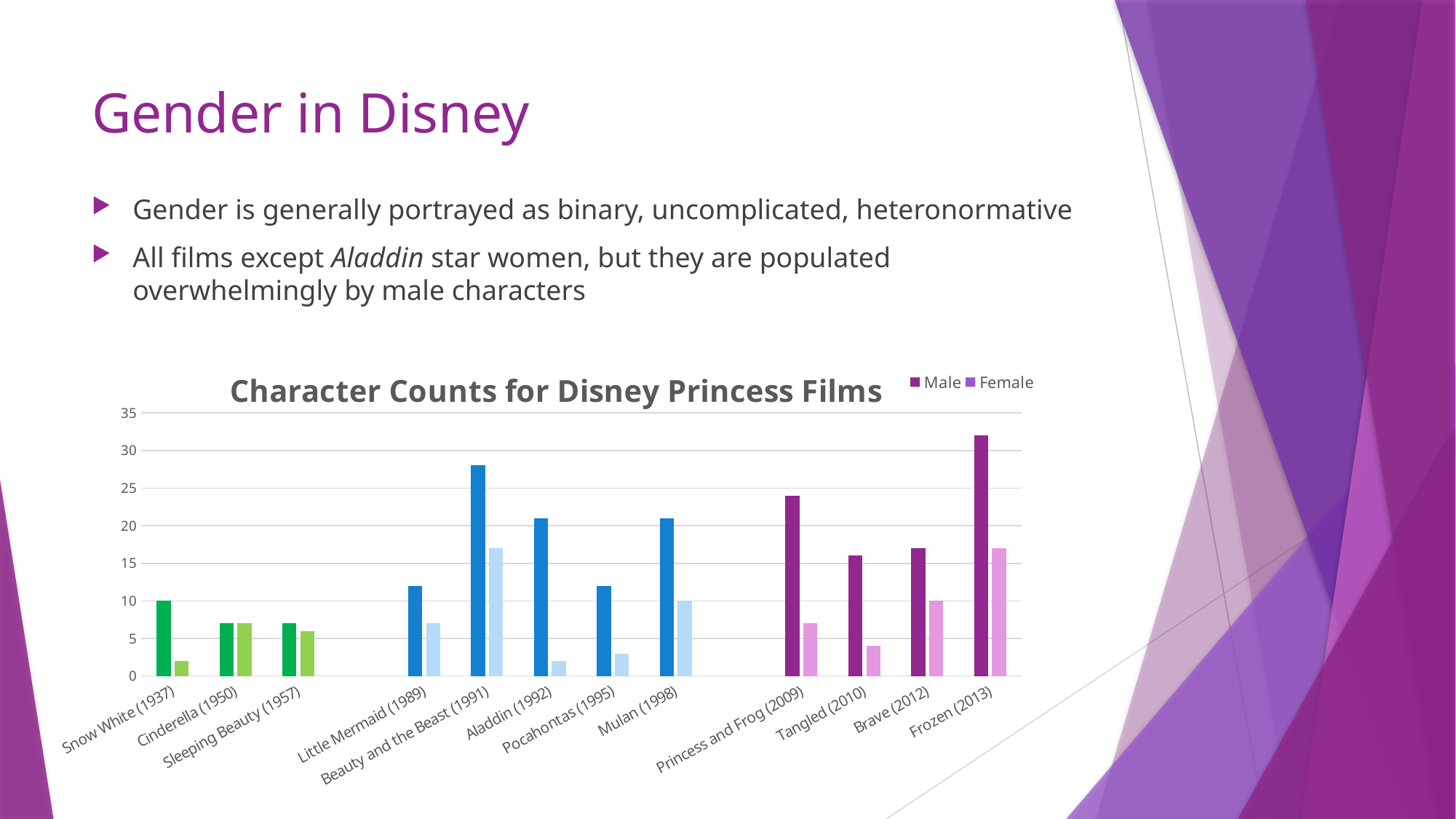
What is the title of the chart? Character Counts for Disney Princess Films What is the Female value for Mulan (1998)? 10 Which film has the highest Male value? Frozen (2013) How many series does the chart legend list? 2 Is the Male value for Frozen (2013) greater or less than 30? greater Which is larger, the Male value for Beauty and the Beast (1991) or the Male value for Aladdin (1992)? Beauty and the Beast (1991) Is the Female value for Tangled (2010) greater or less than 5? less Which is larger, the Female value for Frozen (2013) or the Female value for Tangled (2010)? Frozen (2013) What type of chart is shown on the slide? Bar chart What is the Male value for Snow White (1937)? 10 How many films are shown on the x axis of the chart? 12 What is the Female value for Brave (2012)? 10